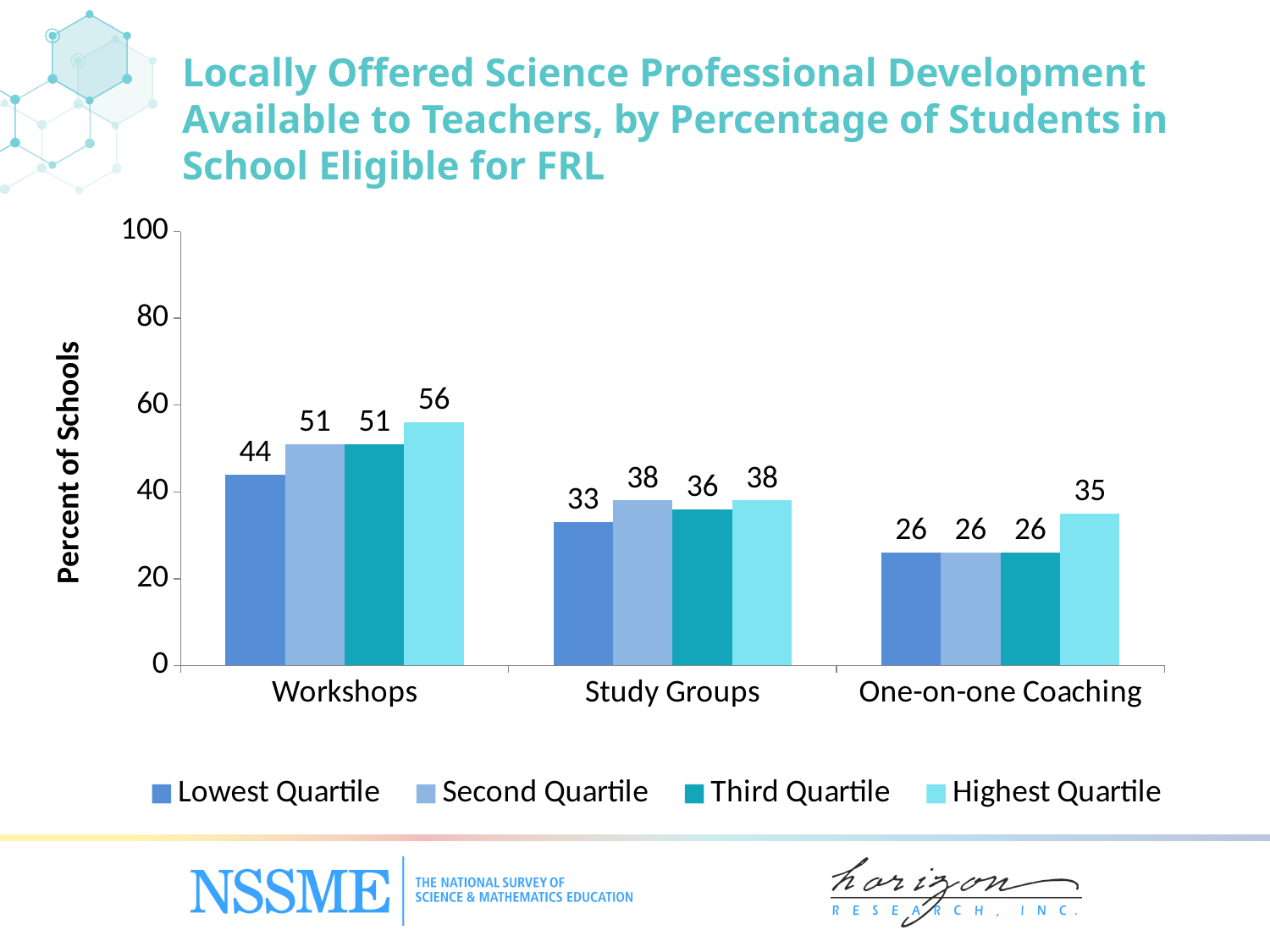
Which category has the lowest value for the Highest Quartile series? One-on-one Coaching What is the label of the y axis? Percent of Schools What is the value for the Highest Quartile for One-on-one Coaching? 35 What is the value for the Highest Quartile for Workshops? 56 Which is larger for Study Groups: the Second Quartile value or the Third Quartile value? Second Quartile What is the value for the Lowest Quartile for Study Groups? 33 How many series does the legend list? 4 What is the difference between the Highest Quartile and Third Quartile values for One-on-one Coaching? 9 What kind of chart is shown on the slide? Bar chart How many categories are shown on the x axis? 3 Which category has the highest value for the Lowest Quartile series? Workshops What is the difference between the Highest Quartile and Lowest Quartile values for Workshops? 12